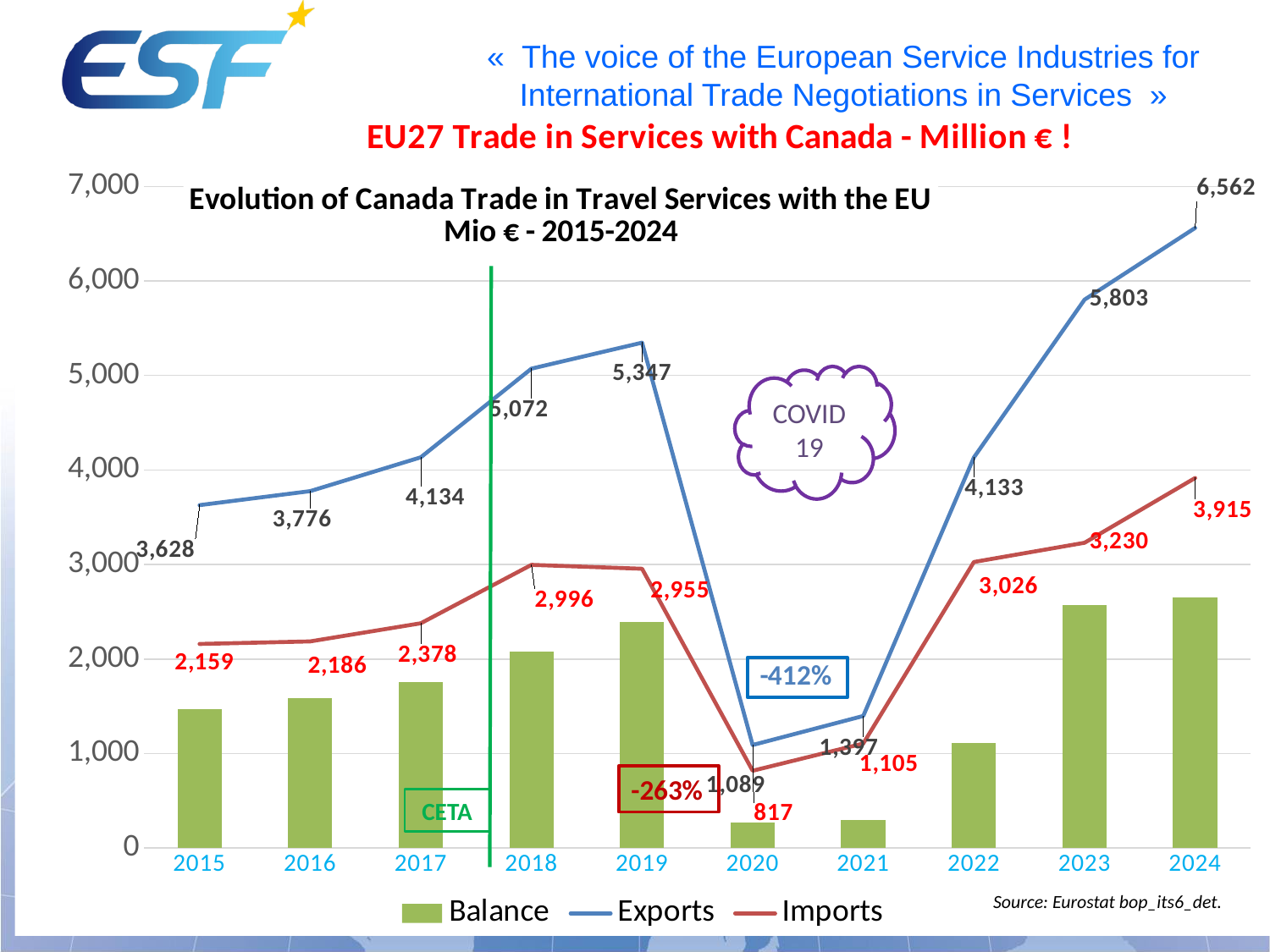
How many years are shown on the x axis? 10 In which year were Exports lowest? 2020 What was the value of Exports in 2019? 5,347 How many series does the legend list? 3 Did Exports rise or fall from 2021 to 2024? rise Which was larger in 2021, Exports or Imports? Exports What is the difference between Exports and Imports in 2024? 2,647 Is the Balance bar for 2020 greater or less than 1,000? less What was the value of Imports in 2020? 817 Is the Balance bar for 2024 greater or less than 2,000? greater In which year were Imports highest? 2024 What was the value of Exports in 2024? 6,562